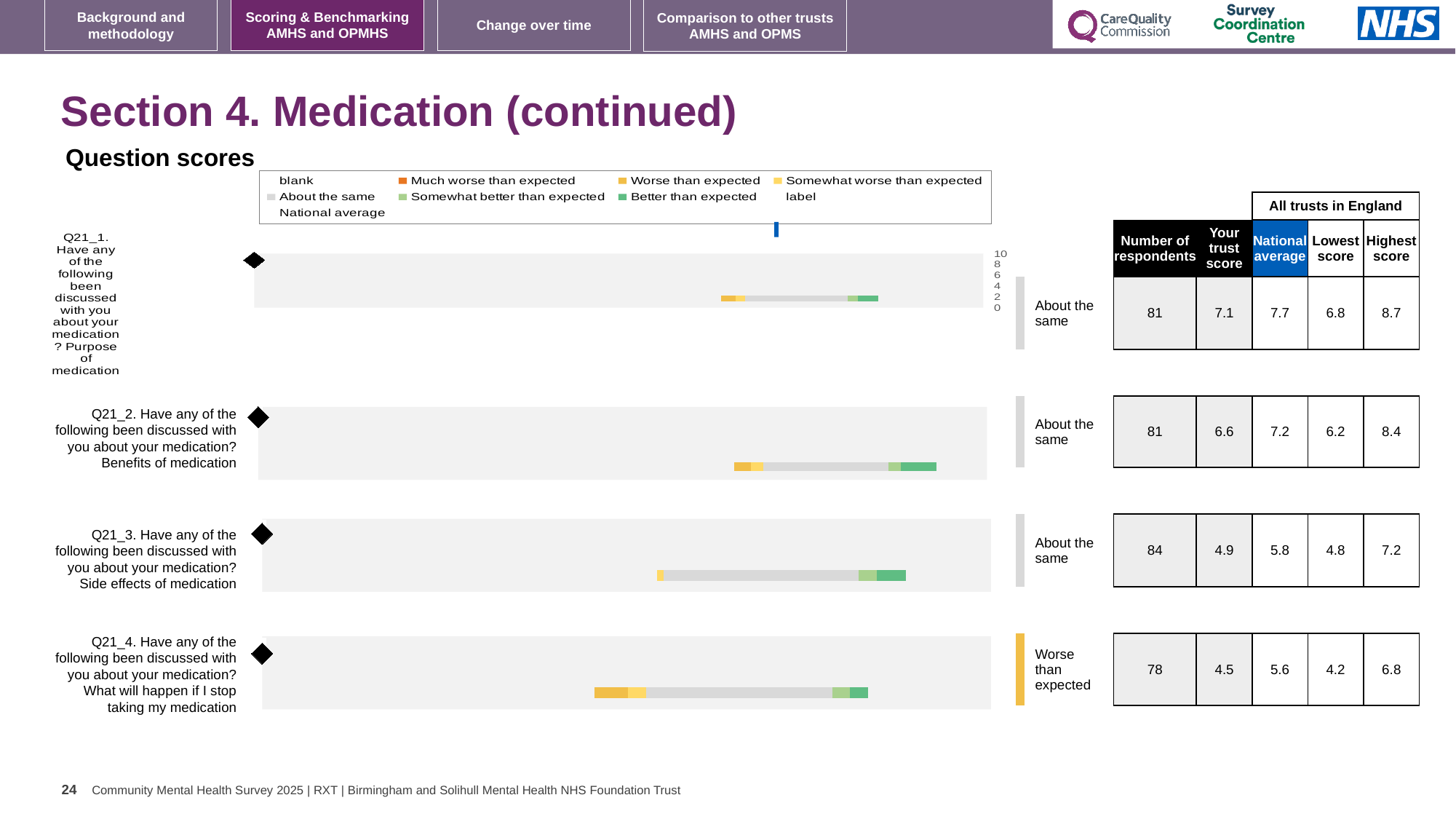
Which question has the highest 'Your trust score'? Q21_1 (Purpose of medication) How many questions (bars) are plotted in the question scores chart? 4 What is the national average for Q21_3 (Side effects of medication)? 5.8 What kind of chart is used to show the question scores on this slide? Bar chart Which question is labelled 'Worse than expected' on the chart? Q21_4 (What will happen if I stop taking my medication) How many entries does the legend of the question scores chart list? 9 What is the difference between the national average and the trust score for Q21_2 (Benefits of medication)? 0.6 Which question has the lowest 'Your trust score'? Q21_4 (What will happen if I stop taking my medication) Is the trust score for Q21_3 (Side effects of medication) higher or lower than the national average? Lower What is the highest score among all trusts in England for Q21_2 (Benefits of medication)? 8.4 How many respondents answered Q21_4 (What will happen if I stop taking my medication)? 78 What is the 'Your trust score' for Q21_1 (Purpose of medication)? 7.1